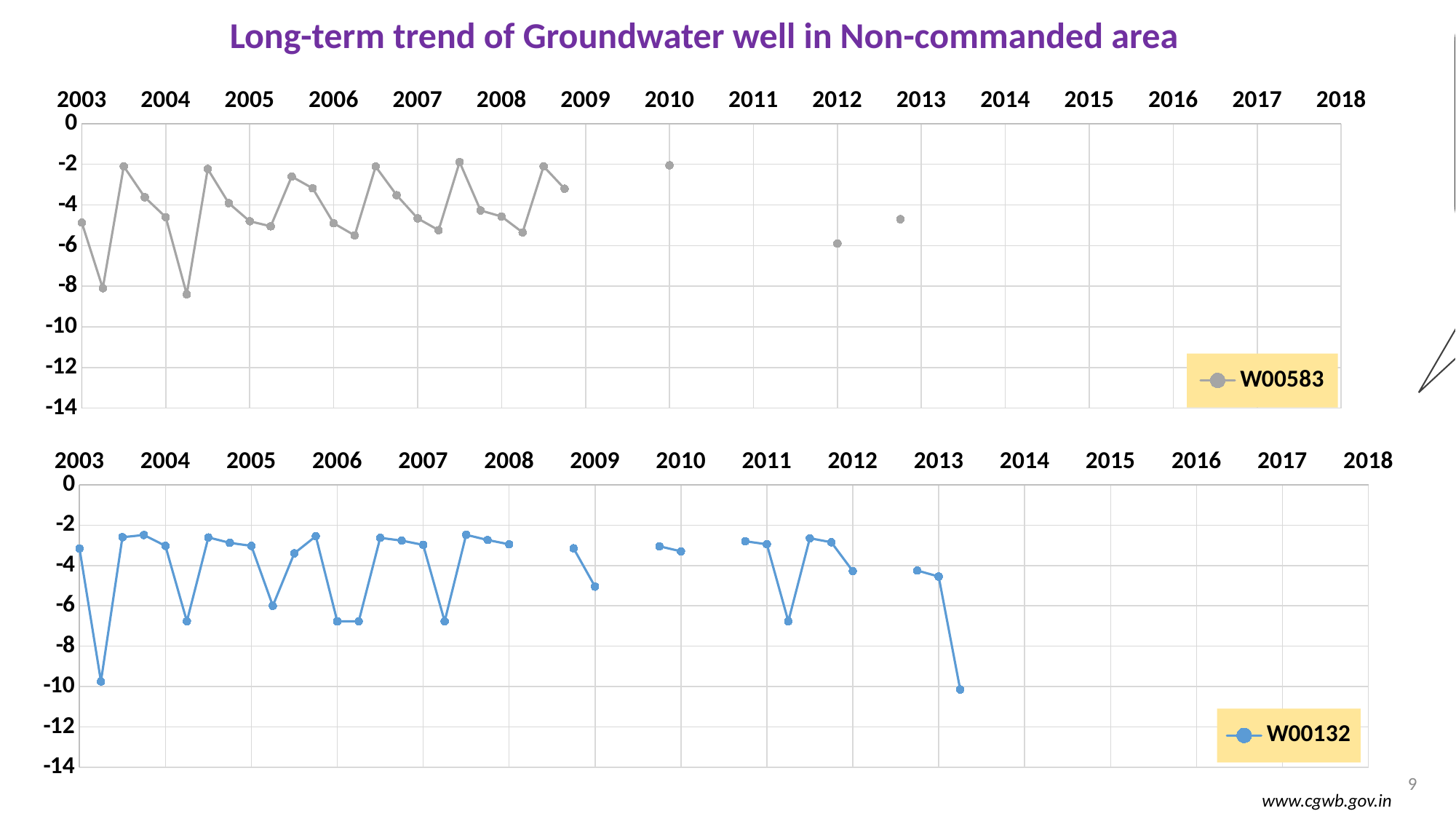
In the top chart (W00583), is the lowest value plotted greater or less than -6? less What is the lowest value shown on the y axis of the bottom chart? -14 What kind of chart is the top chart on the slide? line chart In the bottom chart (W00132), is the lowest value plotted greater or less than -8? less How many year labels are shown along the x axis of the top chart? 16 In the bottom chart (W00132), is the last plotted point (around 2013-2014) greater or less than -8? less How many series does the legend of the top chart list? 1 Which chart reaches a lower minimum value, the top chart (W00583) or the bottom chart (W00132)? bottom chart (W00132) What kind of chart is the bottom chart on the slide? line chart What is the name of the series shown in the top chart's legend? W00583 What is the name of the series shown in the bottom chart's legend? W00132